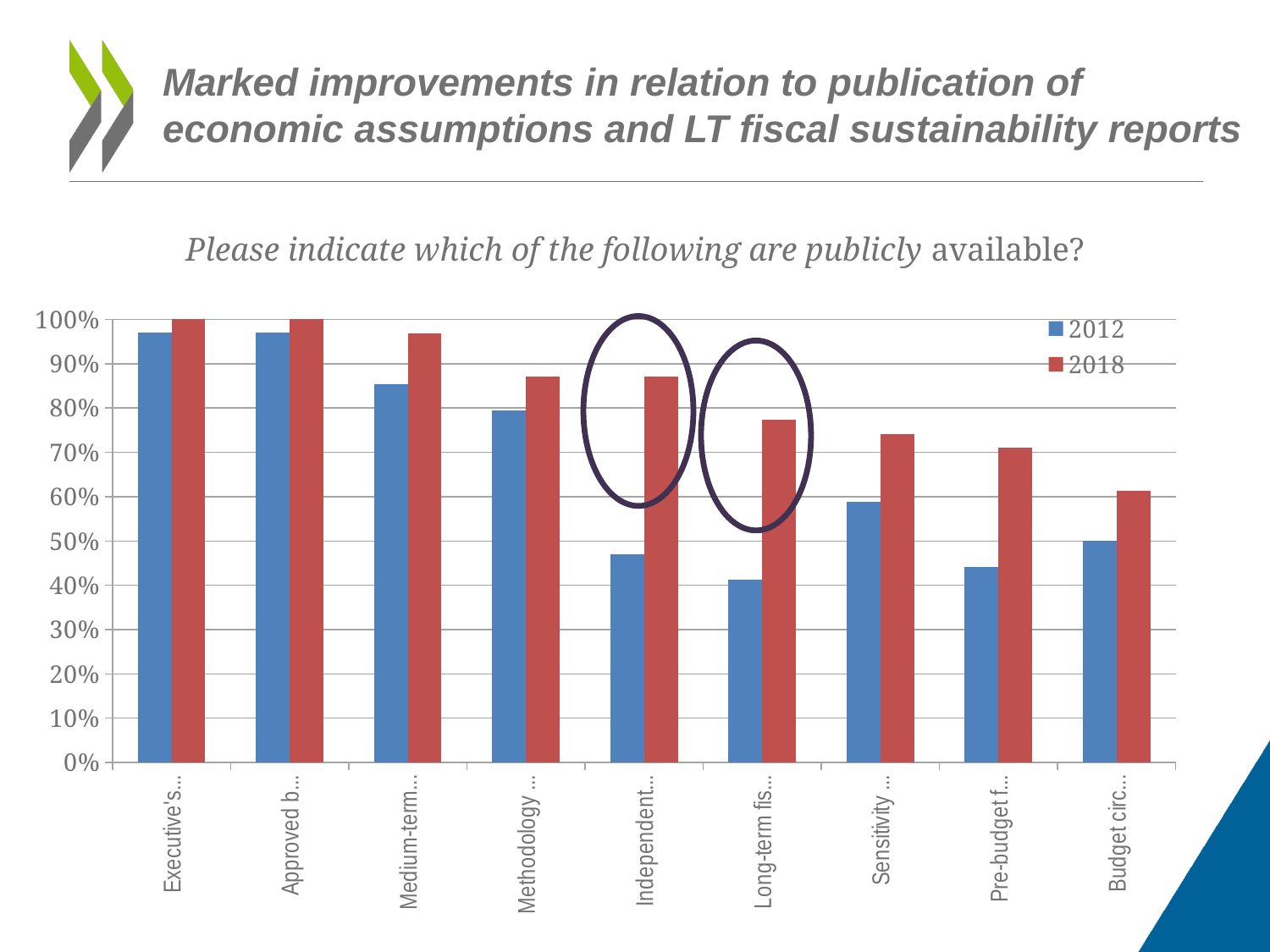
How many categories are shown on the x axis? 9 Which years are listed in the legend? 2012 and 2018 What kind of chart is shown on the slide? bar chart Is the 2018 value for 'Independent...' greater or less than 80%? greater What is the 2018 value for the 'Executive's...' category? 100% How many series does the legend list? 2 Which colour represents the 2018 series? red Which category has the lowest 2018 value? Budget circ... For the 'Pre-budget f...' category, which series has the larger value, 2012 or 2018? 2018 Is the 2012 value for 'Sensitivity ...' greater or less than 50%? greater What is the 2018 value for the 'Approved b...' category? 100% Is the 2012 value for 'Long-term fis...' greater or less than 50%? less